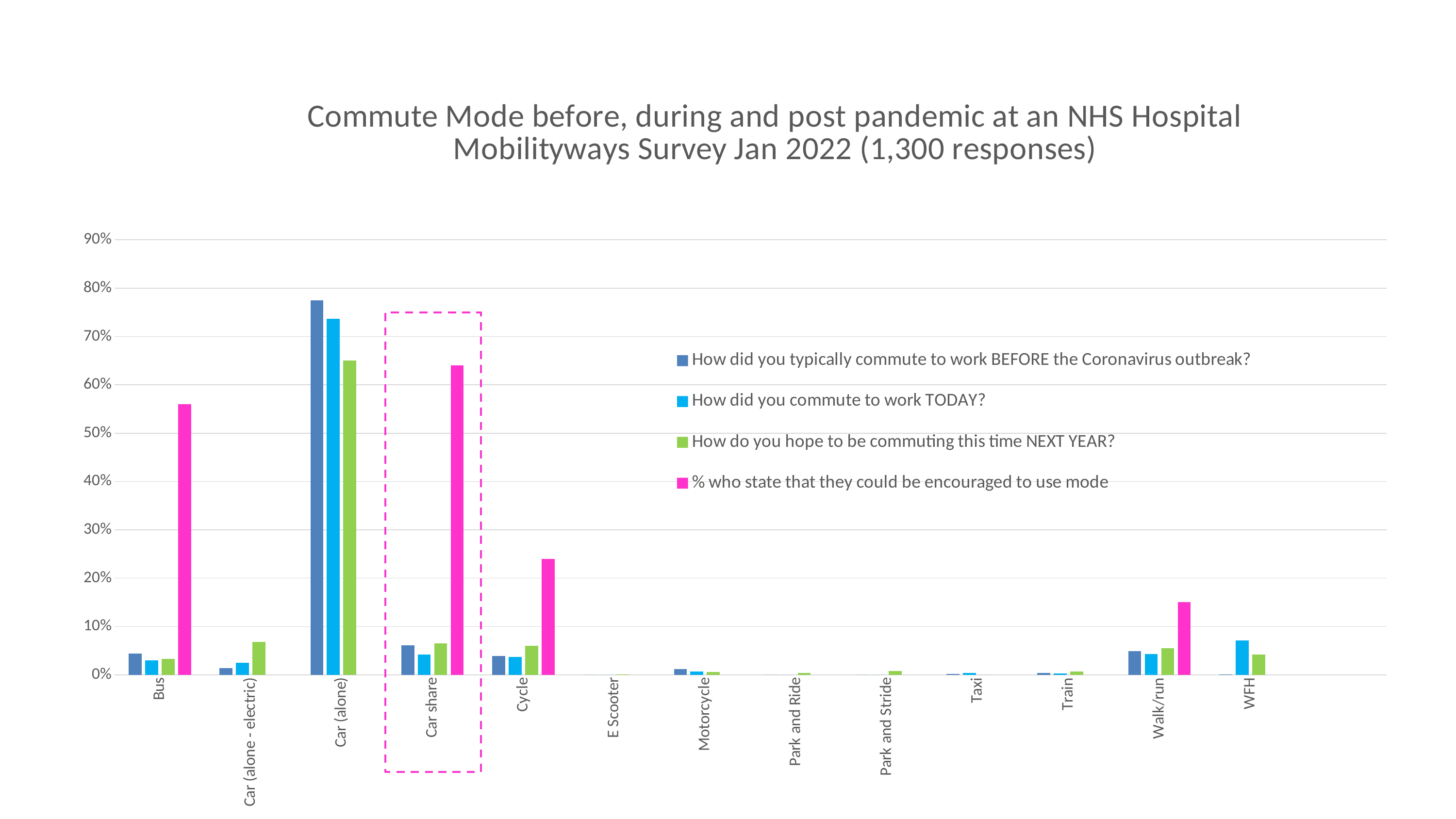
For Car (alone), which is larger: the 'How did you commute to work TODAY?' value or the 'How do you hope to be commuting this time NEXT YEAR?' value? How did you commute to work TODAY? What kind of chart is shown on the slide? Bar chart Which category on the chart is highlighted with a dashed pink box? Car share Which commute mode has the highest value for 'How did you typically commute to work BEFORE the Coronavirus outbreak?' Car (alone) Is the value for Walk/run in the '% who state that they could be encouraged to use mode' series greater or less than 10%? greater Is the value for Car (alone) in the 'BEFORE the Coronavirus outbreak' series greater or less than 70%? greater For WFH, which is larger: the 'How did you commute to work TODAY?' value or the 'How do you hope to be commuting this time NEXT YEAR?' value? How did you commute to work TODAY? Is the value for Bus in the '% who state that they could be encouraged to use mode' series greater or less than 50%? greater How many series does the legend list? 4 How many commute mode categories are shown on the x axis? 13 Which commute mode has the highest value for '% who state that they could be encouraged to use mode'? Car share